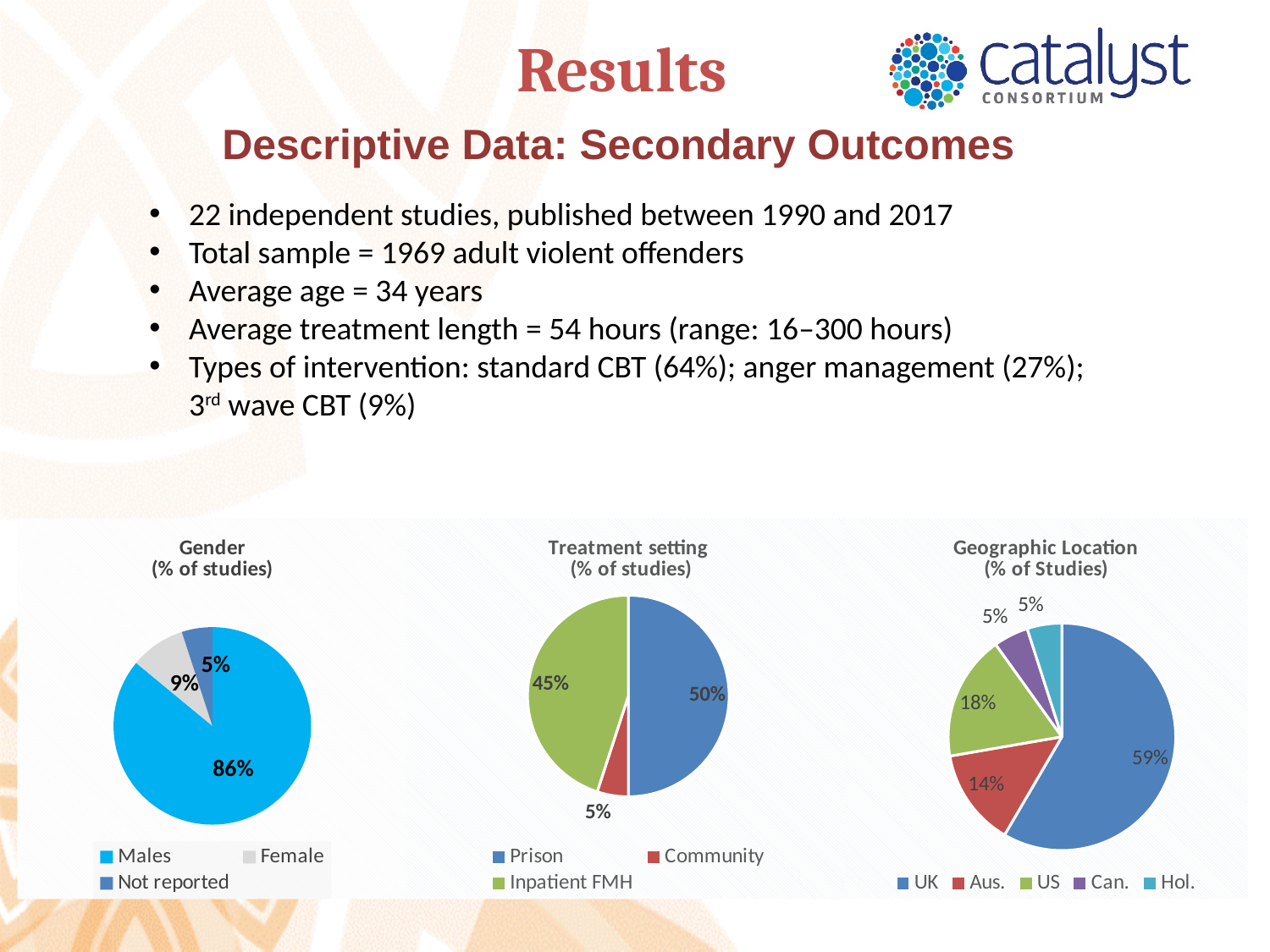
In the Treatment setting (% of studies) chart, what share of studies is Inpatient FMH? 45% In the Gender (% of studies) chart, what share of studies is Female? 9% What type of chart is the Treatment setting (% of studies) chart? Pie chart In the Gender (% of studies) chart, which category has the smallest share? Not reported How many categories does the legend of the Geographic Location (% of Studies) chart list? 5 In the Treatment setting (% of studies) chart, what is the difference between the Prison and Inpatient FMH shares? 5% In the Geographic Location (% of Studies) chart, which is larger, the share for Aus. or the share for US? US In the Geographic Location (% of Studies) chart, what share of studies is from the US? 18% In the Treatment setting (% of studies) chart, which setting has the largest share? Prison In the Geographic Location (% of Studies) chart, what is the difference between the UK and Aus. shares? 45% In the Geographic Location (% of Studies) chart, which location has the largest share? UK In the Gender (% of studies) chart, what share of studies is Males? 86%